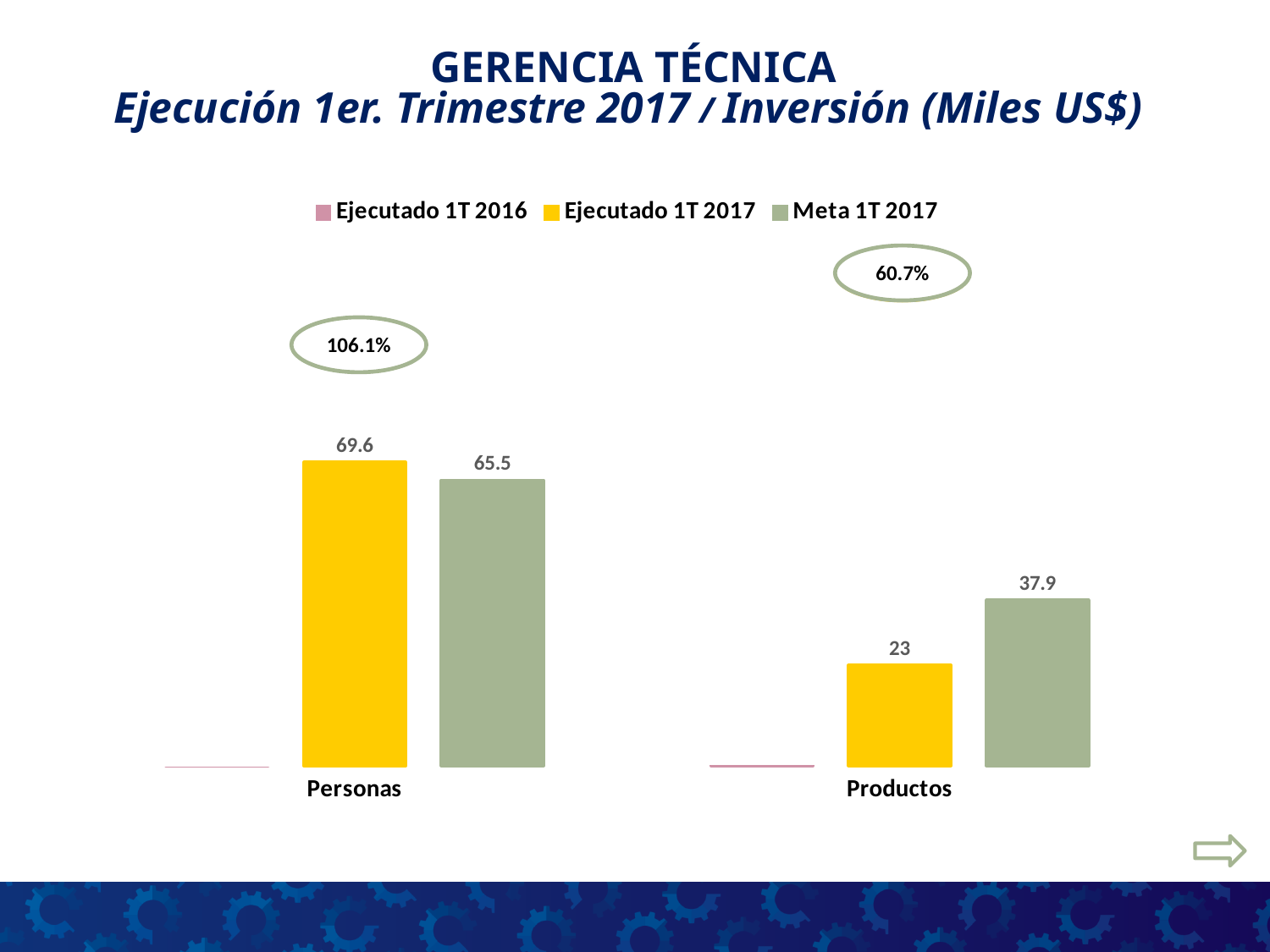
For Productos, which is larger: Ejecutado 1T 2017 or Meta 1T 2017? Meta 1T 2017 Which category has the higher Ejecutado 1T 2017 value, Personas or Productos? Personas What is the difference between the Meta 1T 2017 and Ejecutado 1T 2017 values for Productos? 14.9 What kind of chart is shown on the slide? Bar chart What percentage is shown in the oval above the Productos bars? 60.7% What is the Ejecutado 1T 2017 value for Productos? 23 What is the Meta 1T 2017 value for Personas? 65.5 What is the difference between the Ejecutado 1T 2017 values for Personas and Productos? 46.6 What is the Meta 1T 2017 value for Productos? 37.9 How many series does the legend list? 3 How many categories are shown on the x axis? 2 What is the Ejecutado 1T 2017 value for Personas? 69.6